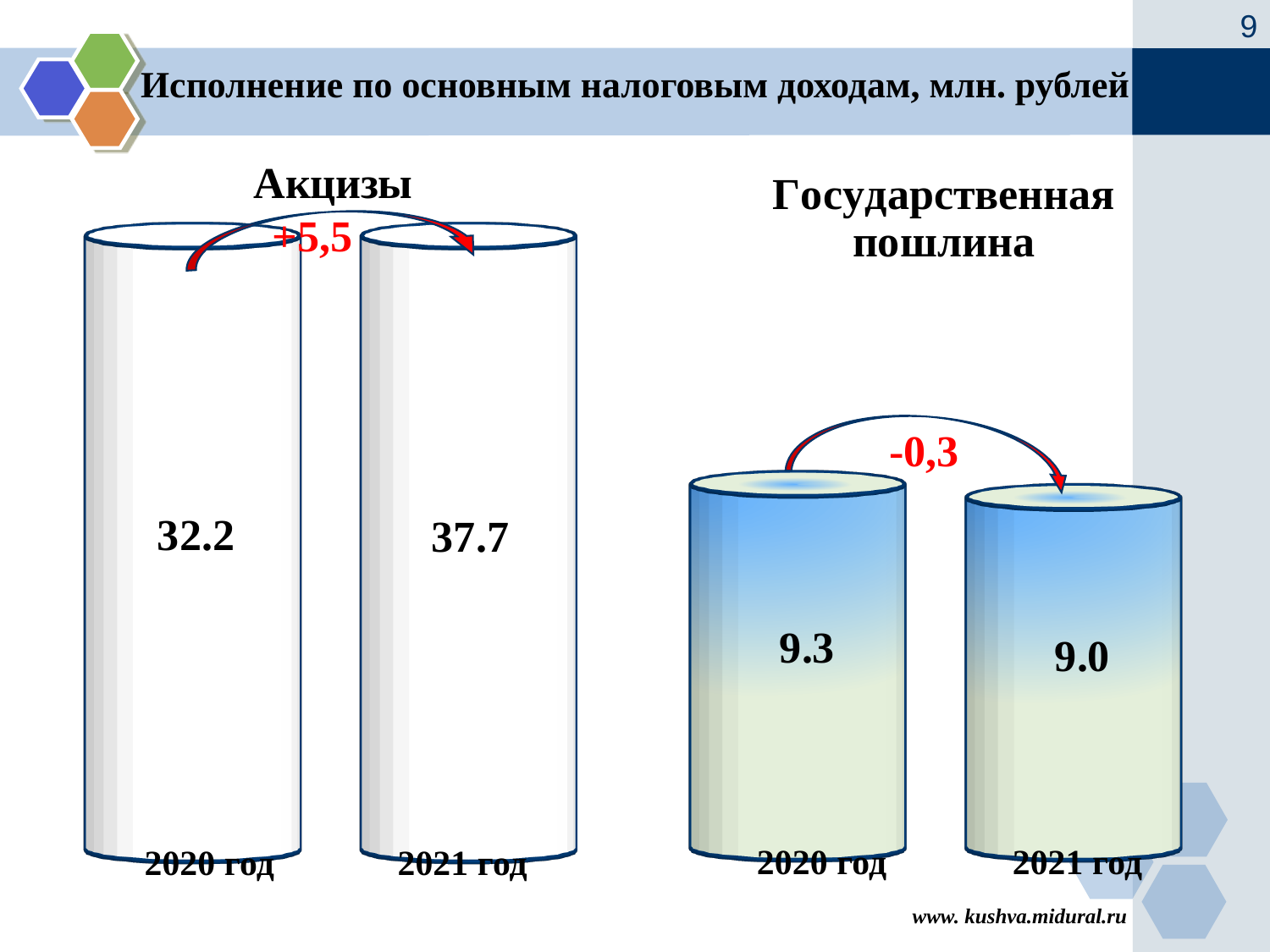
In the 'Государственная пошлина' chart, what is the value for 2020 год? 9.3 In the 'Акцизы' chart, what is the value for 2021 год? 37.7 In the 'Государственная пошлина' chart, is the value for 2020 год larger or smaller than the value for 2021 год? larger In the 'Акцизы' chart, what is the value for 2020 год? 32.2 How many categories are shown in the 'Акцизы' chart? 2 In the 'Государственная пошлина' chart, what is the difference between the 2020 год and 2021 год values? 0.3 In the 'Акцизы' chart, do the values rise or fall from 2020 год to 2021 год? rise In the 'Государственная пошлина' chart, what is the value for 2021 год? 9.0 In the 'Акцизы' chart, what is the difference between the 2021 год and 2020 год values? 5.5 What kind of chart is the 'Государственная пошлина' chart? bar chart In the 'Государственная пошлина' chart, which year has the lower value? 2021 год In the 'Акцизы' chart, which year has the higher value? 2021 год